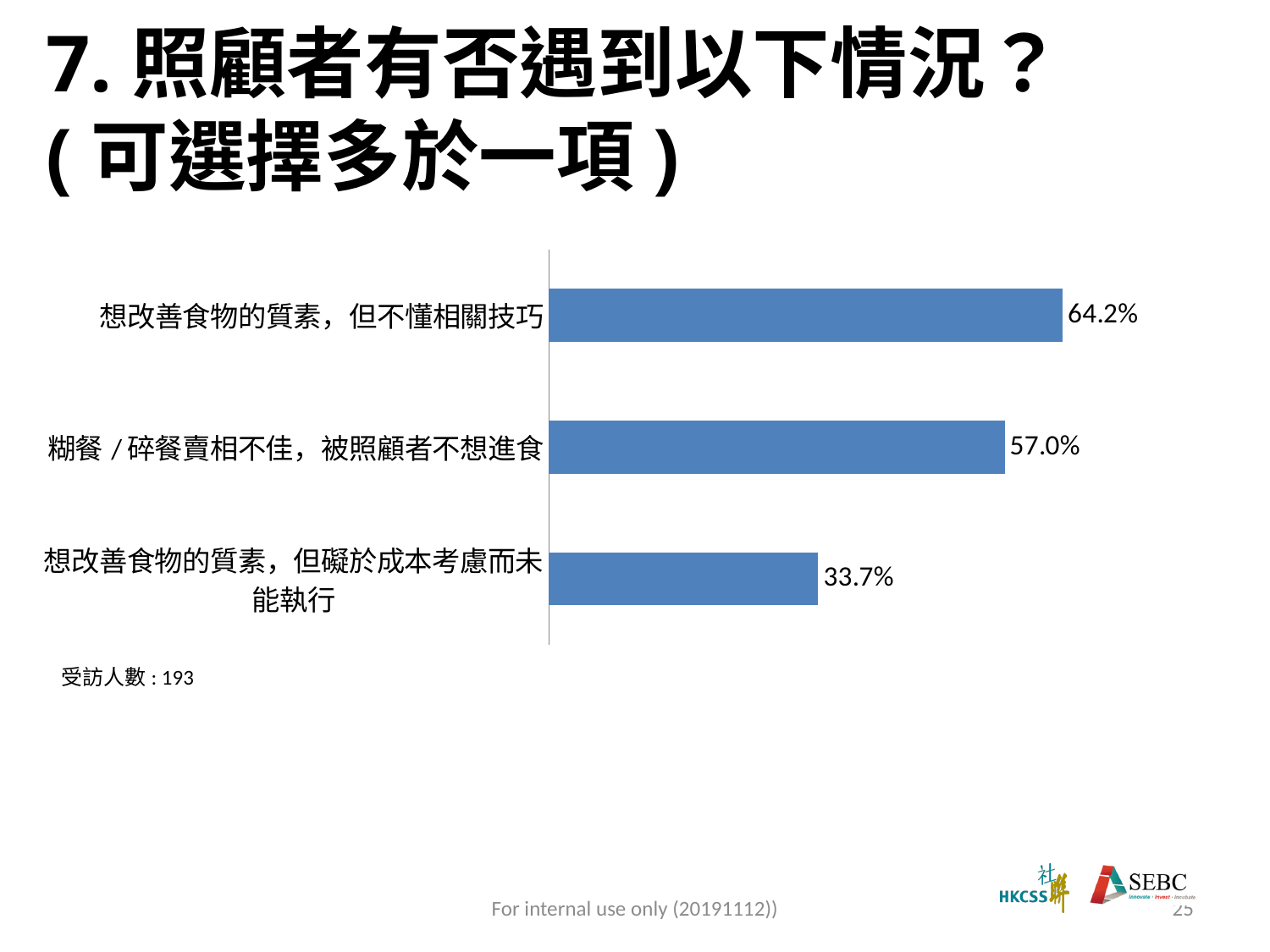
Which is larger: the value for 糊餐／碎餐賣相不佳，被照顧者不想進食 or the value for 想改善食物的質素，但礙於成本考慮而未能執行? 糊餐／碎餐賣相不佳，被照顧者不想進食 What colour are the bars in the chart? Blue How many respondents (受訪人數) does the slide report? 193 Which category has the highest percentage? 想改善食物的質素，但不懂相關技巧 What is the value for 糊餐／碎餐賣相不佳，被照顧者不想進食? 57.0% How many categories are shown in the chart? 3 What percentage of caregivers selected 想改善食物的質素，但不懂相關技巧? 64.2% Which category has the lowest percentage? 想改善食物的質素，但礙於成本考慮而未能執行 What is the value for 想改善食物的質素，但礙於成本考慮而未能執行? 33.7% What kind of chart is shown on the slide? Bar chart What is the difference between the values for 想改善食物的質素，但不懂相關技巧 and 糊餐／碎餐賣相不佳，被照顧者不想進食? 7.2% What is the difference between the values for 糊餐／碎餐賣相不佳，被照顧者不想進食 and 想改善食物的質素，但礙於成本考慮而未能執行? 23.3%